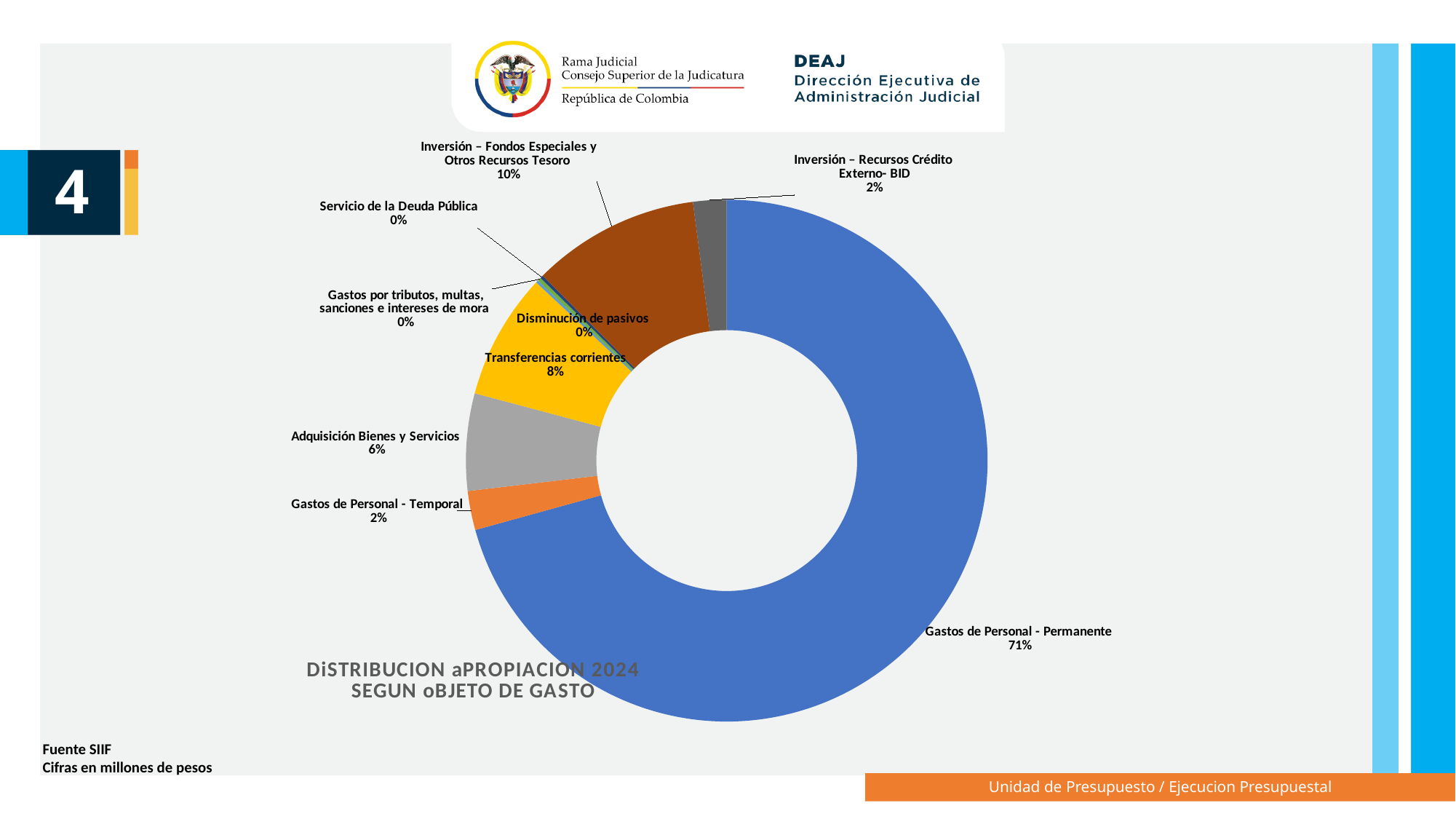
Which category has the largest share of the chart? Gastos de Personal - Permanente What percentage is shown for Inversión – Recursos Crédito Externo- BID? 2% What kind of chart is shown on the slide? Doughnut (pie) chart What share of the chart does Gastos de Personal - Permanente represent? 71% What percentage is shown for Servicio de la Deuda Pública? 0% What percentage is shown for Transferencias corrientes? 8% Which is larger, Transferencias corrientes or Adquisición Bienes y Servicios? Transferencias corrientes What percentage is shown for Adquisición Bienes y Servicios? 6% How many categories are labelled on the chart? 9 What percentage is shown for Inversión – Fondos Especiales y Otros Recursos Tesoro? 10% What is the difference in percentage points between Gastos de Personal - Permanente and Inversión – Fondos Especiales y Otros Recursos Tesoro? 61 What is the title of the chart? DiSTRIBUCION aPROPIACION 2024 SEGUN oBJETO DE GASTO